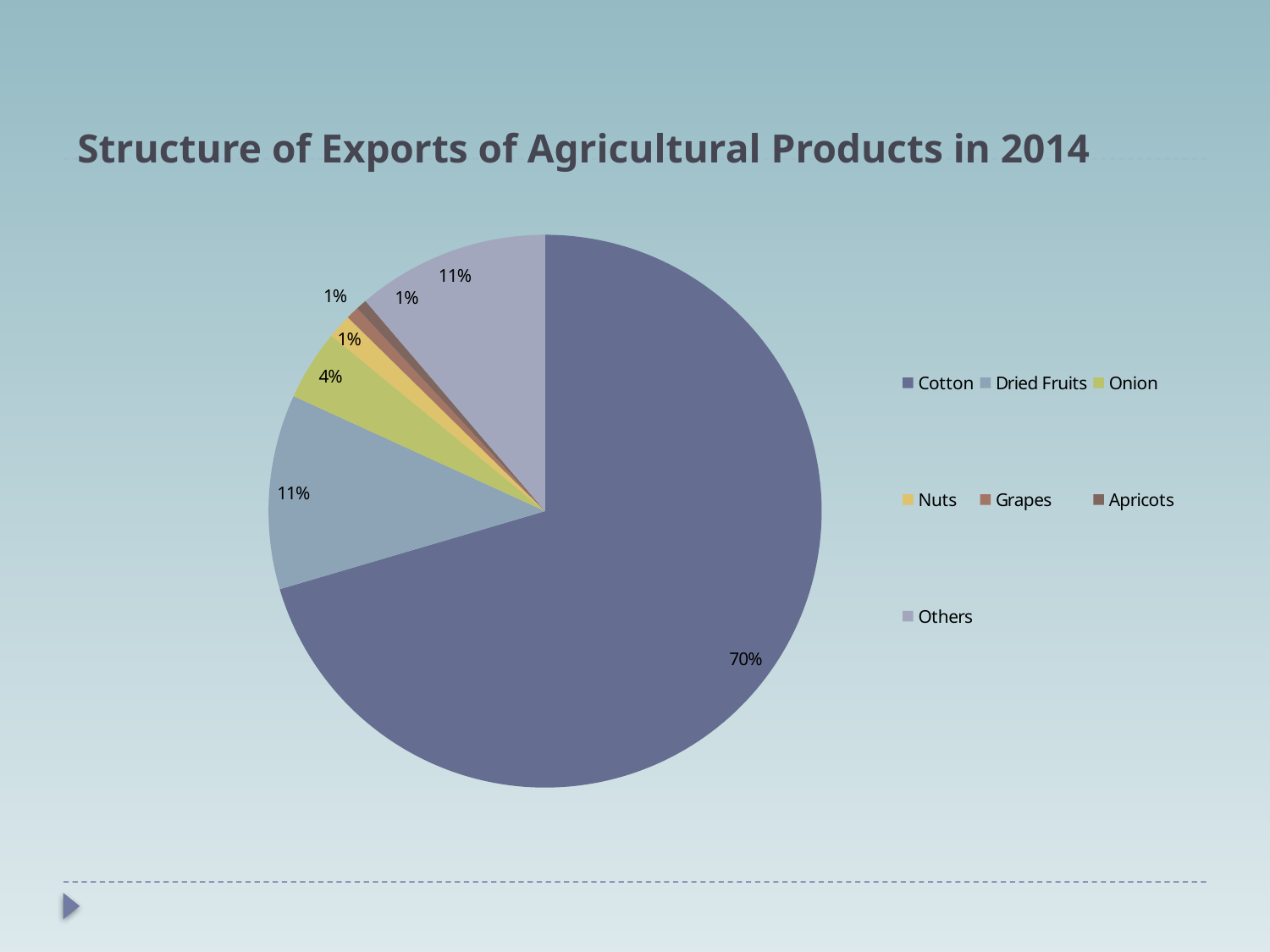
Which is larger, the share for Onion or the share for Grapes? Onion What is the difference between the share for Others and the share for Onion? 7% What is the difference between the share for Cotton and the share for Dried Fruits? 59% What share of the pie does Cotton hold? 70% What kind of chart is shown on the slide? Pie chart What share of the pie does Dried Fruits hold? 11% What is the value shown for Others? 11% How many categories does the legend list? 7 Which is larger, the share for Cotton or the share for Dried Fruits? Cotton Which category has the largest slice of the pie? Cotton What is the value shown for Nuts? 1% What is the value shown for Onion? 4%